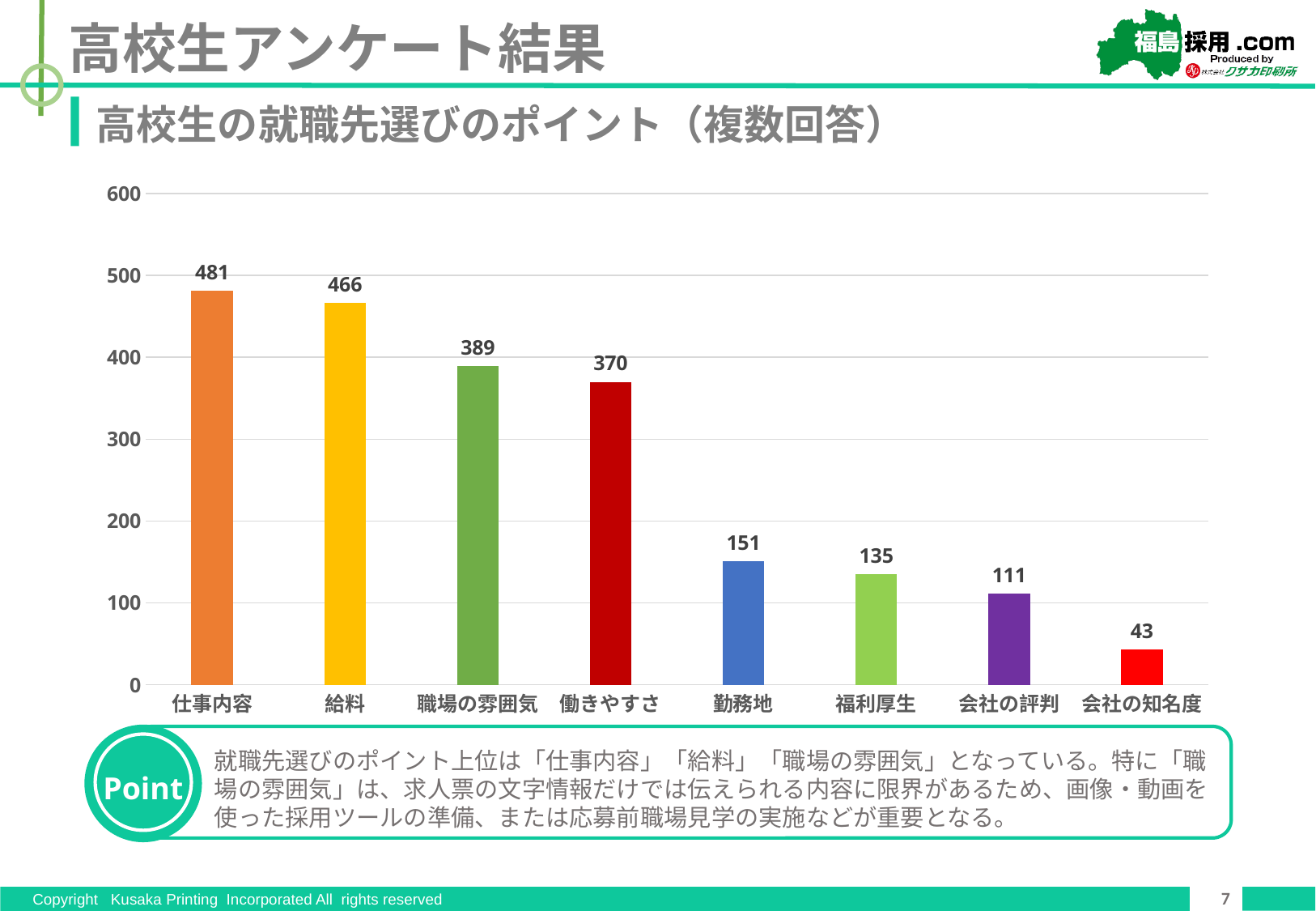
How many categories are shown on the x axis? 8 What is the value for 仕事内容? 481 What kind of chart is shown on the slide? bar chart What is the difference between the values for 職場の雰囲気 and 働きやすさ? 19 What is the value for 会社の知名度? 43 Which category has the lowest value? 会社の知名度 What is the value for 勤務地? 151 Which category has the highest value? 仕事内容 Is the value for 働きやすさ greater or less than 400? less What is the difference between the values for 仕事内容 and 給料? 15 Which is larger, the value for 福利厚生 or the value for 会社の評判? 福利厚生 Do the values rise or fall from left to right along the x axis? fall